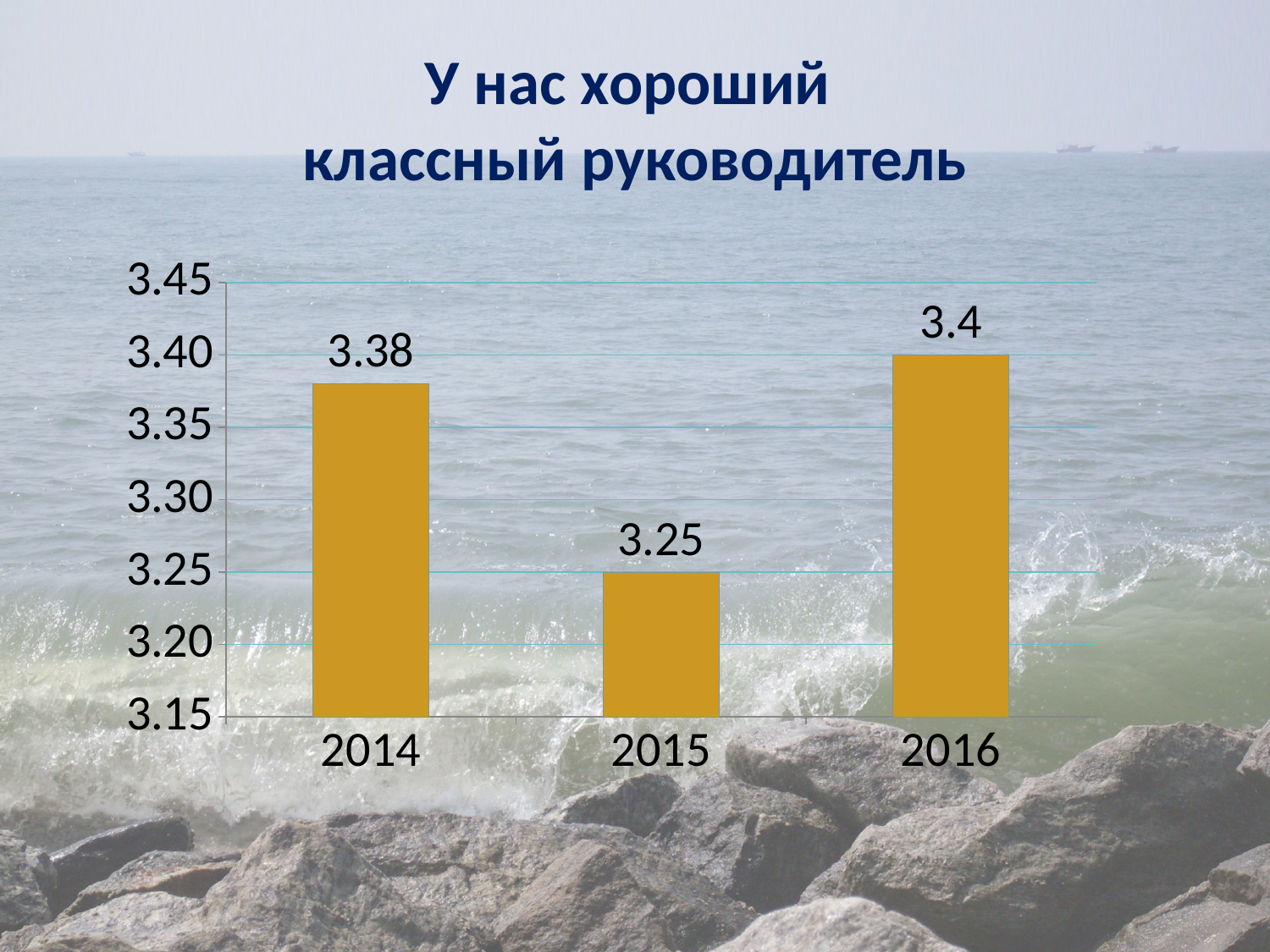
What is the value for 2016? 3.4 Which is larger, the value for 2014 or the value for 2016? 2016 Is the value for 2015 greater or less than 3.30? less Which year has the lowest value? 2015 What is the title of the slide? У нас хороший классный руководитель How many years are shown on the chart? 3 What is the difference between the values for 2014 and 2015? 0.13 What is the difference between the values for 2016 and 2015? 0.15 What is the value for 2014? 3.38 What kind of chart is shown on the slide? bar chart Which year has the highest value? 2016 What is the value for 2015? 3.25